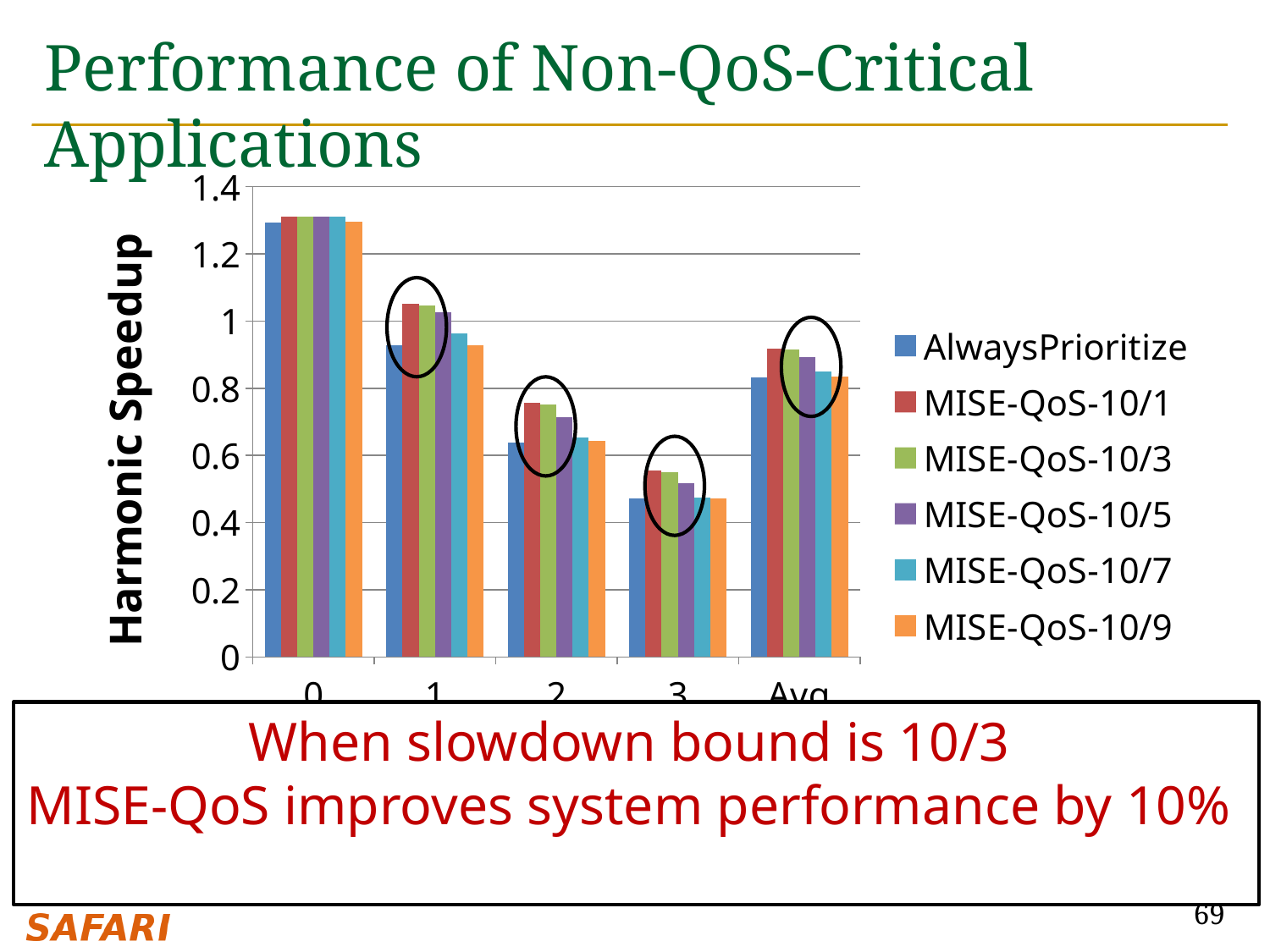
Is the MISE-QoS-10/1 value for category 1 greater or less than 1? greater For category 2, which is larger: the MISE-QoS-10/1 value or the AlwaysPrioritize value? MISE-QoS-10/1 How many categories are shown along the x axis? 5 Which category has the lowest AlwaysPrioritize value? 3 What kind of chart is shown on the slide? bar chart Which category has the highest AlwaysPrioritize value? 0 What is the label of the y axis? Harmonic Speedup How many series does the legend list? 6 Which series is shown in orange in the legend? MISE-QoS-10/9 Is the AlwaysPrioritize value for category 2 greater or less than 0.8? less Is the MISE-QoS-10/9 value for category 0 greater or less than 1.2? greater